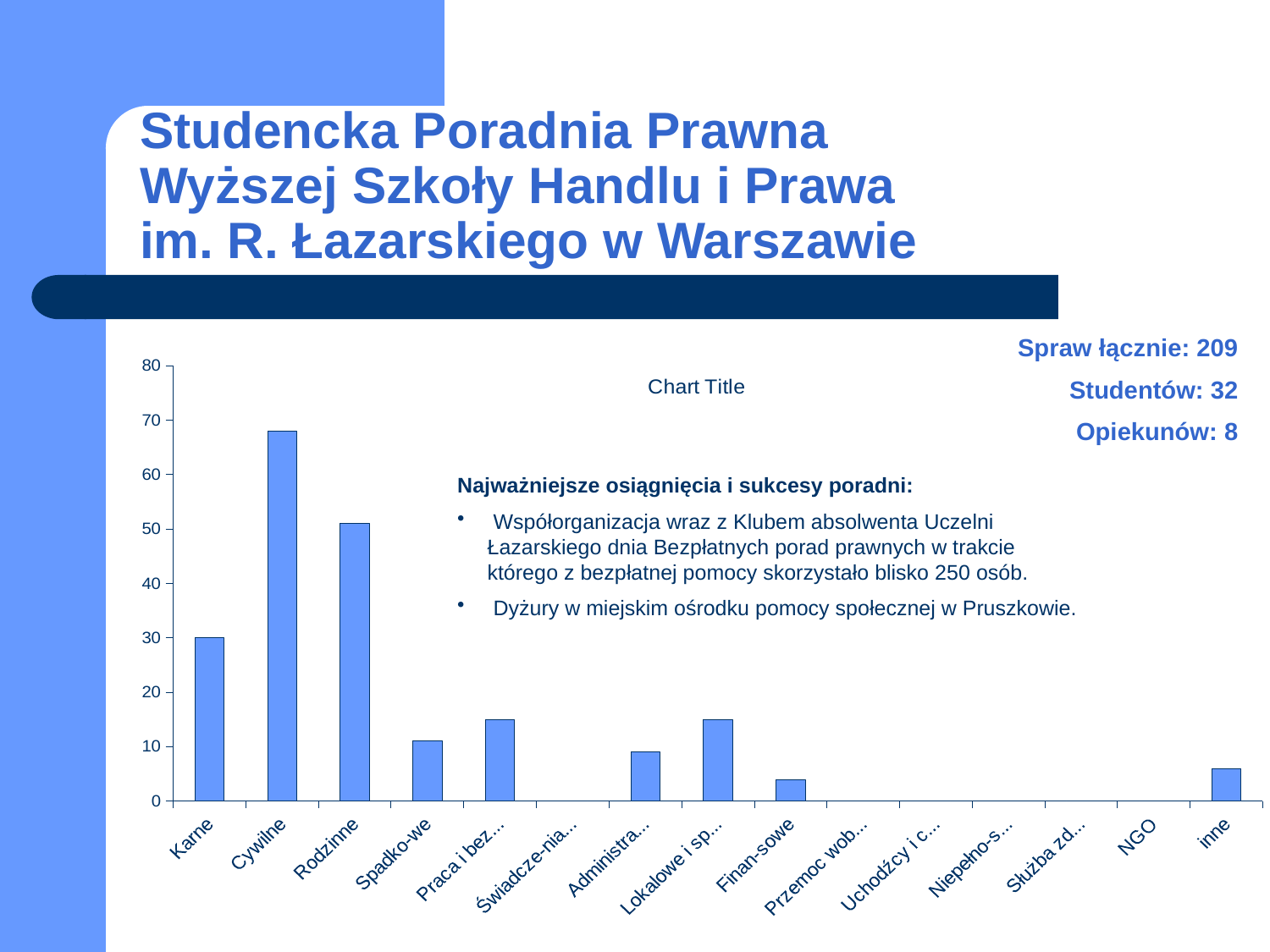
What is the value for Karne in the chart? 30 How many categories are shown on the x axis of the chart? 15 Is the value for Finan-sowe greater or less than 10? less Which is larger, the value for Karne or the value for Administra...? Karne Is the value for Spadko-we greater or less than 20? less Is the value for Cywilne greater or less than 60? greater What kind of chart is shown on the slide? bar chart What is the title shown on the chart? Chart Title Which category has the highest bar in the chart? Cywilne Which is larger, the value for Cywilne or the value for Rodzinne? Cywilne